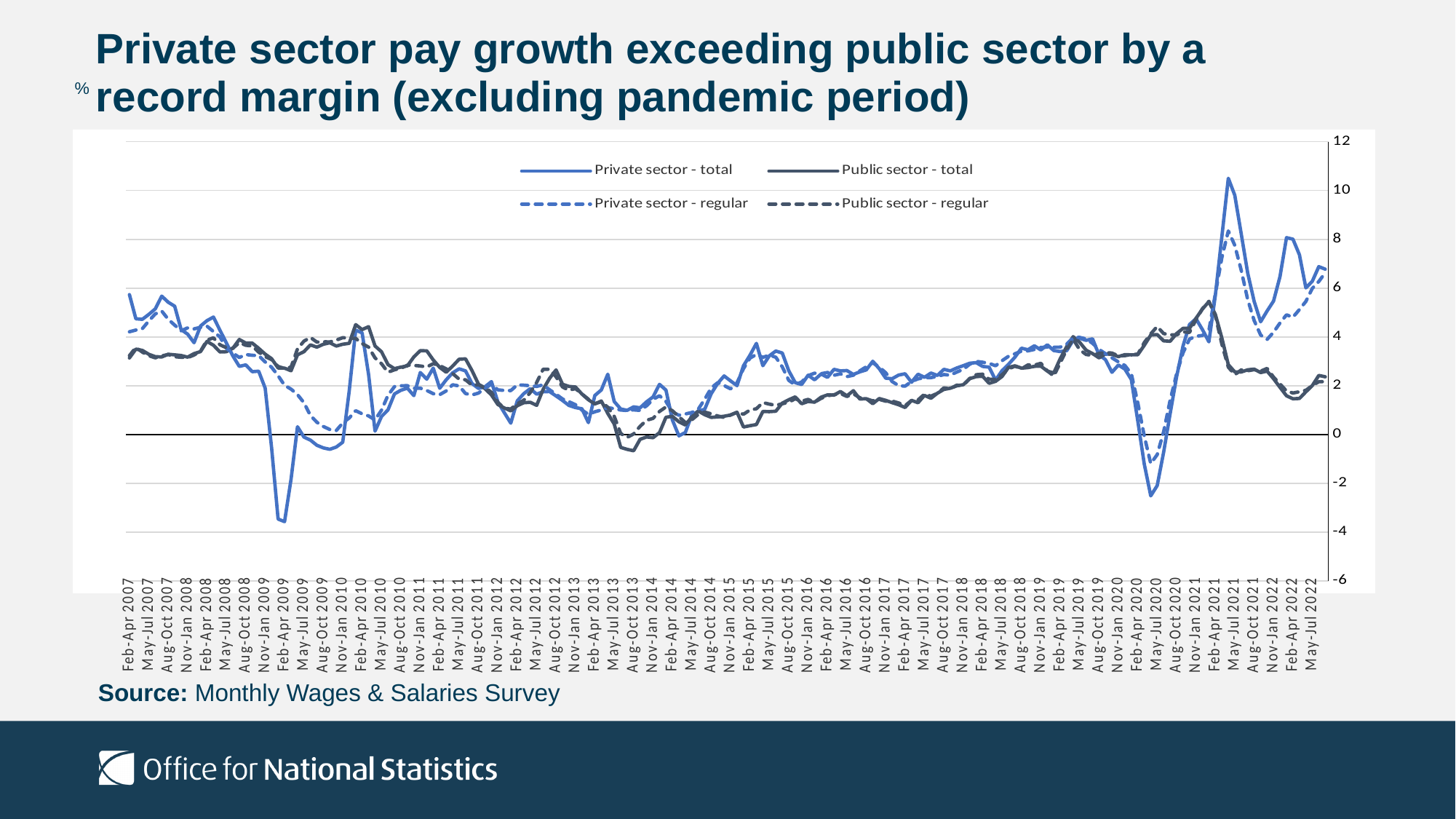
Which series reaches the highest value on the chart? Private sector - total What kind of chart is shown on the slide? line chart Is the value for Private sector - total at Feb-Apr 2009 greater or less than -2? less At May-Jul 2021, which is larger: Private sector - total or Public sector - total? Private sector - total How many series does the legend list? 4 Which series reaches the lowest value on the chart? Private sector - total Which two series are drawn with dashed lines according to the legend? Private sector - regular and Public sector - regular Is the value for Public sector - total at Feb-Apr 2021 greater or less than 4? greater Does Private sector - total rise or fall between Feb-Apr 2020 and May-Jul 2021? rise Is the peak value of Private sector - total around May-Jul 2021 greater or less than 10? greater What is the source cited below the chart? Monthly Wages & Salaries Survey